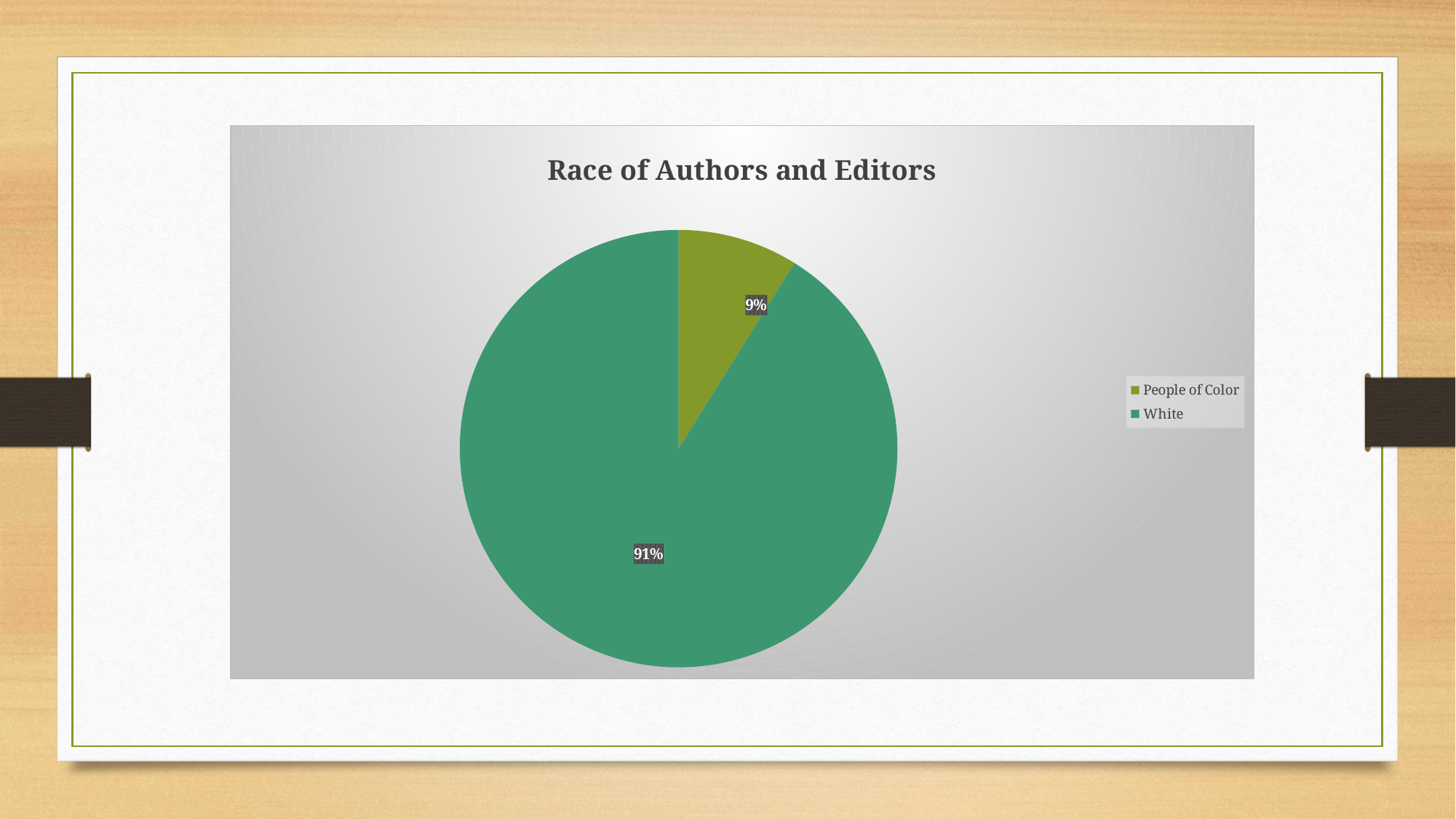
Which legend entry is shown in the lighter olive green colour? People of Color Which category has the smallest slice of the pie? People of Color What is the title of the chart? Race of Authors and Editors How many categories does the pie chart show? 2 What share of the pie does the White slice represent? 91% What is the difference in percentage points between the White slice and the People of Color slice? 82 What percentage of the pie is labelled for White? 91% Which category has the largest slice of the pie? White How many entries does the legend list? 2 Which slice is larger, White or People of Color? White What kind of chart is shown on the slide? pie chart What percentage of the pie is labelled for People of Color? 9%